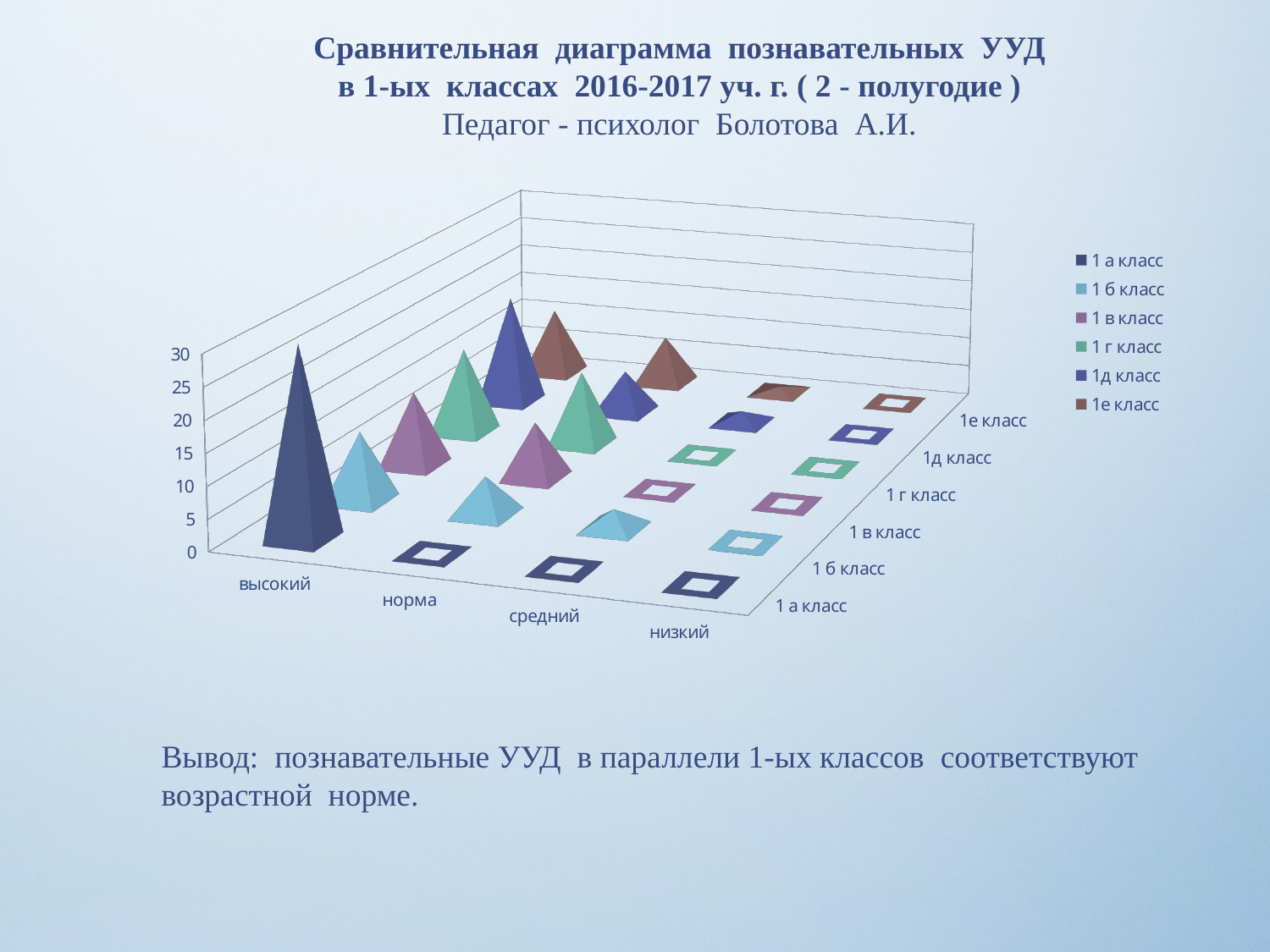
How many categories are shown along the x axis of the chart? 4 Is the value for 1 а класс in the category высокий greater or less than 15? greater Is the value for 1 а класс in the category низкий greater or less than 5? less What are the four categories on the x axis of the chart? высокий, норма, средний, низкий How many series does the chart legend list? 6 Is the value for 1е класс in the category низкий greater or less than 5? less For the series 1 а класс, which category has the highest value? высокий Which series is listed last in the chart legend? 1е класс For the series 1 б класс, which is larger: the value for средний or the value for низкий? средний In the category высокий, which is larger: the value for 1 а класс or the value for 1 б класс? 1 а класс What kind of chart is shown on the slide? bar chart